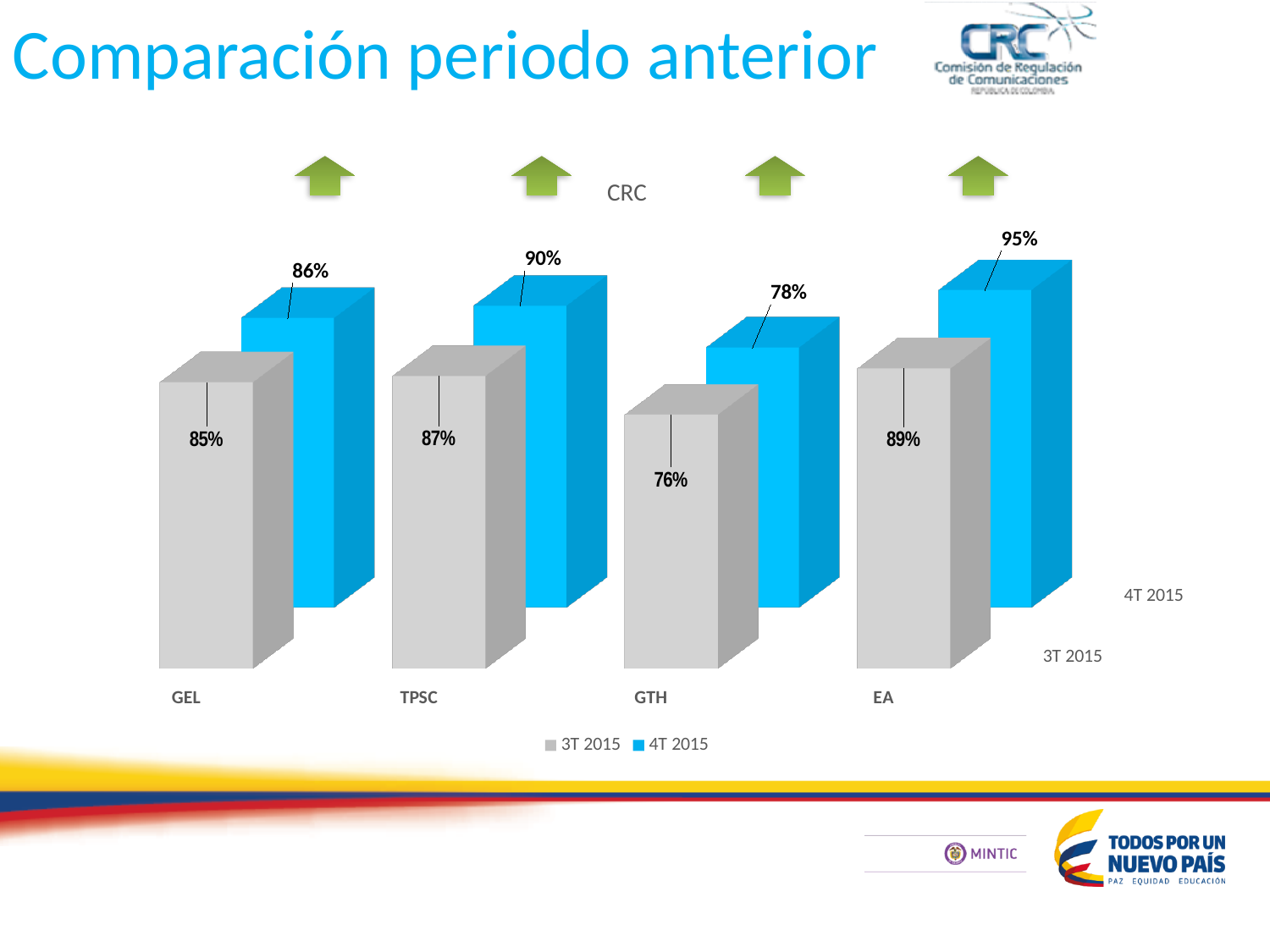
How many series does the legend list? 2 What is the difference between the 4T 2015 and 3T 2015 values for EA? 6% Which is larger, the 4T 2015 value for GTH or the 3T 2015 value for GEL? 3T 2015 value for GEL What is the value for GTH in 3T 2015? 76% What kind of chart is shown on the slide? Bar chart Which category has the highest value in 4T 2015? EA Which category has the lowest value in 3T 2015? GTH What is the value for GEL in 4T 2015? 86% What is the difference between the 4T 2015 and 3T 2015 values for TPSC? 3% How many categories are shown on the x axis? 4 What is the value for TPSC in 3T 2015? 87% What is the value for EA in 4T 2015? 95%